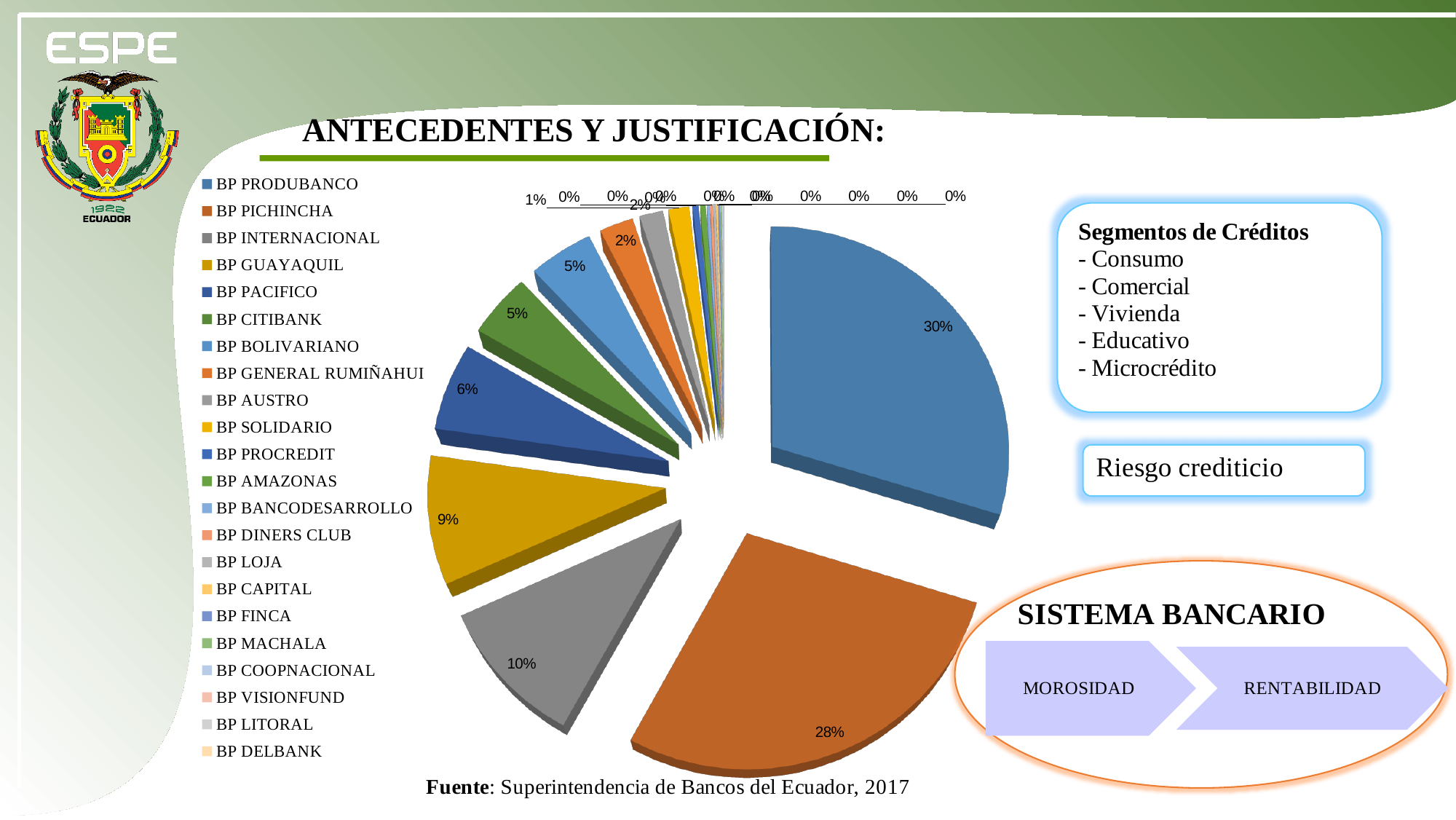
What is the value shown for BP INTERNACIONAL? 10% What is the value shown for BP GUAYAQUIL? 9% What share of the pie does BP PRODUBANCO hold? 30% What source is cited below the pie chart? Superintendencia de Bancos del Ecuador, 2017 What is the difference in percentage points between BP PRODUBANCO and BP PICHINCHA? 2 percentage points Which bank has the largest slice of the pie chart? BP PRODUBANCO How many banks are listed in the legend of the pie chart? 22 What is the value shown for BP PACIFICO? 6% Which bank is the first entry in the chart legend? BP PRODUBANCO What kind of chart is shown on the slide? Pie chart What share of the pie does BP PICHINCHA hold? 28% Which is larger, the slice for BP INTERNACIONAL or the slice for BP GUAYAQUIL? BP INTERNACIONAL